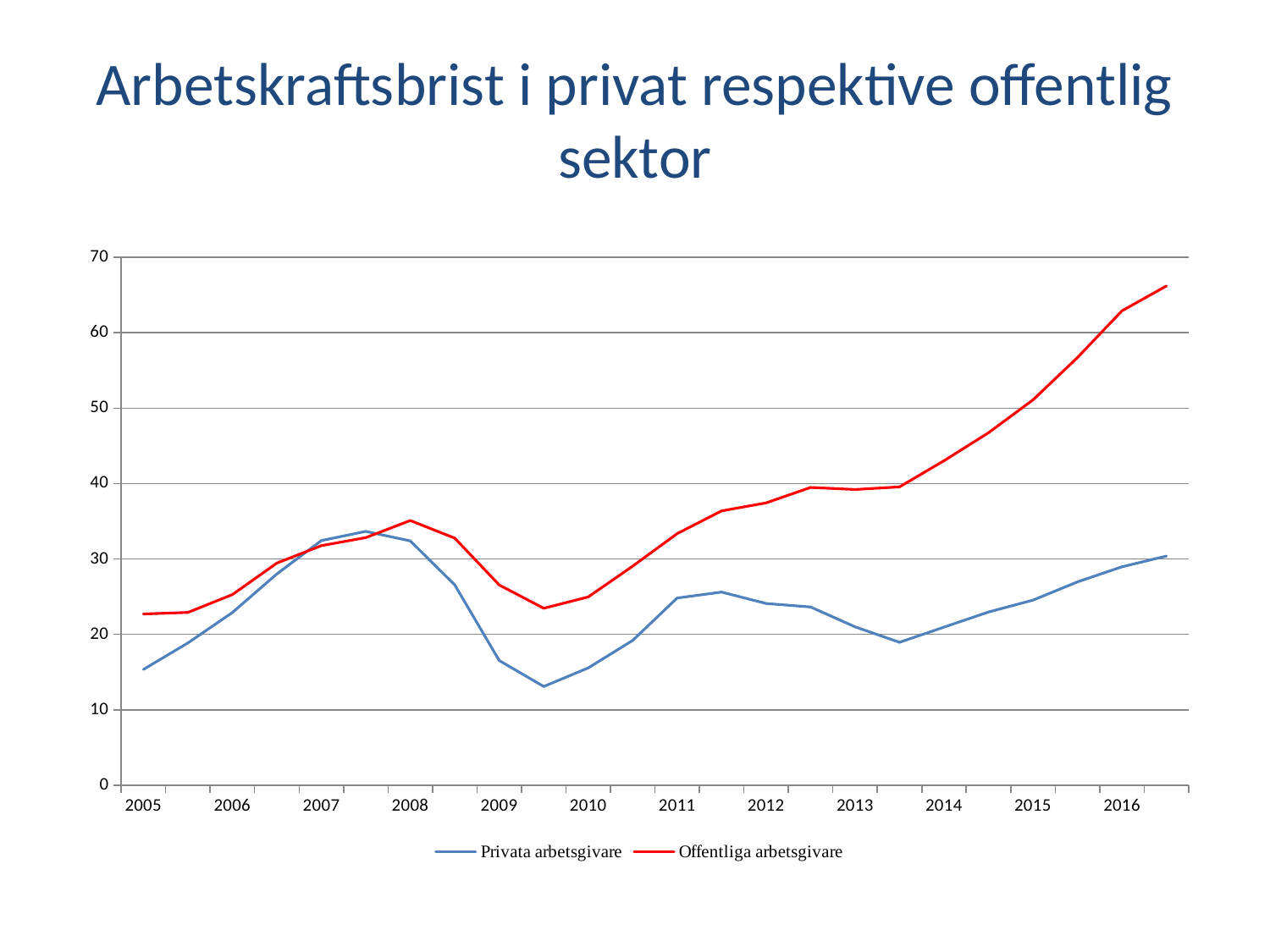
Is the value for Offentliga arbetsgivare at the end of 2016 greater or less than 60? greater In 2016, which series has the higher value, Privata arbetsgivare or Offentliga arbetsgivare? Offentliga arbetsgivare Is the value for Offentliga arbetsgivare in 2015 greater or less than 40? greater What kind of chart is shown on the slide? line chart How many series does the legend list? 2 Is the value for Privata arbetsgivare in 2005 greater or less than 20? less What are the two series named in the legend? Privata arbetsgivare and Offentliga arbetsgivare Which colour is used for the Offentliga arbetsgivare line? red How many years are labelled on the x axis? 12 In which year does the Offentliga arbetsgivare line reach its highest value? 2016 Does the Offentliga arbetsgivare line rise or fall from 2013 to 2016? rise